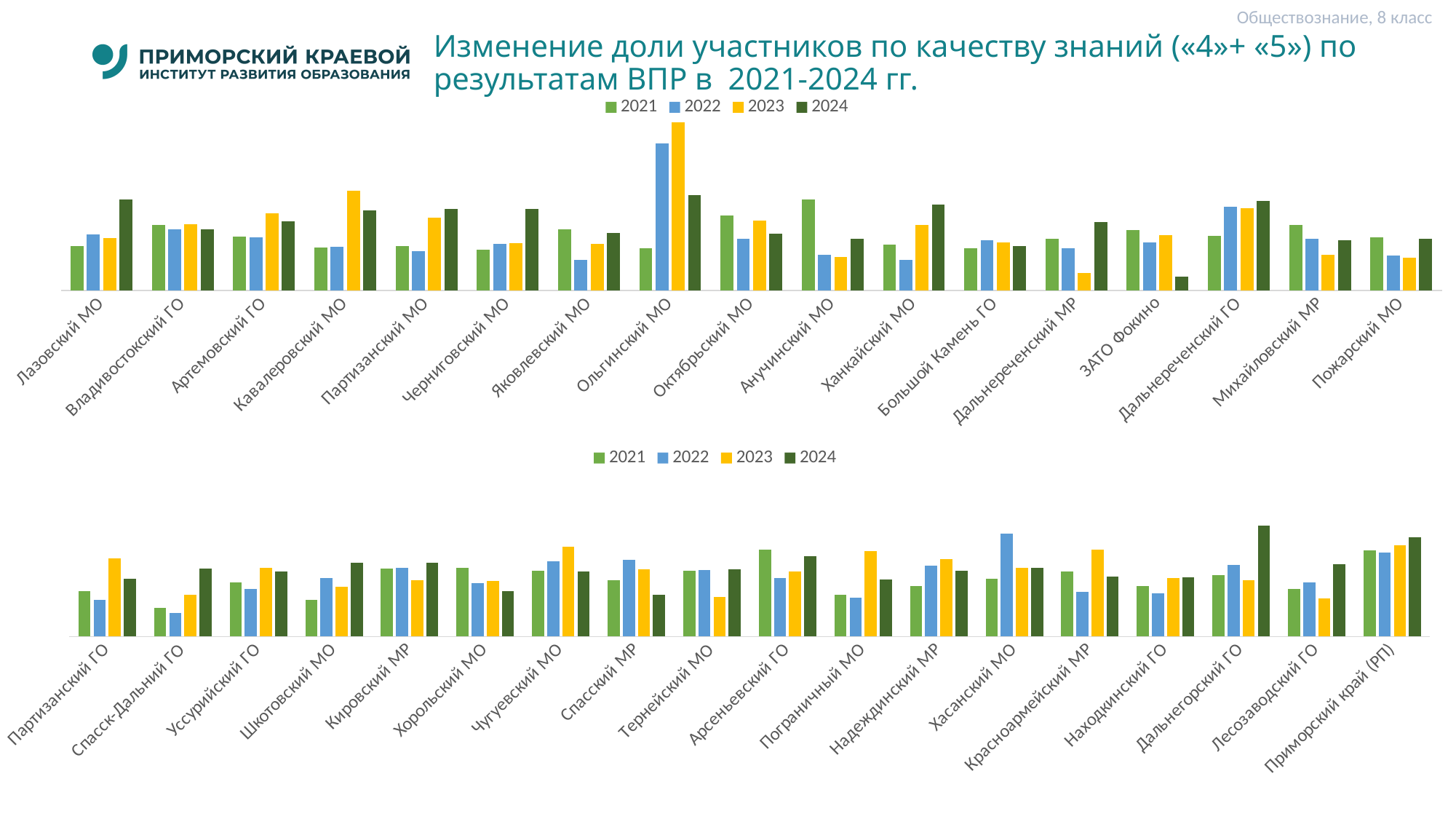
In the top chart, which category has the lowest value for the 2023 series? Дальнереченский МР In the bottom chart, which category has the lowest value for the 2022 series? Спасск-Дальний ГО How many series does the legend of the top chart list? 4 How many categories are shown on the x axis of the top chart? 17 What are the legend entries of the bottom chart? 2021, 2022, 2023, 2024 In the bottom chart, for Дальнегорский ГО, which is larger: the 2024 value or the 2023 value? 2024 How many categories are shown on the x axis of the bottom chart? 18 In the top chart, which category has the lowest value for the 2024 series? ЗАТО Фокино What kind of chart is the top chart on the slide? Bar chart In the top chart, for Кавалеровский МО, which is larger: the 2023 value or the 2021 value? 2023 In the top chart, which category has the highest value for the 2022 series? Ольгинский МО In the bottom chart, which category has the highest value for the 2022 series? Хасанский МО